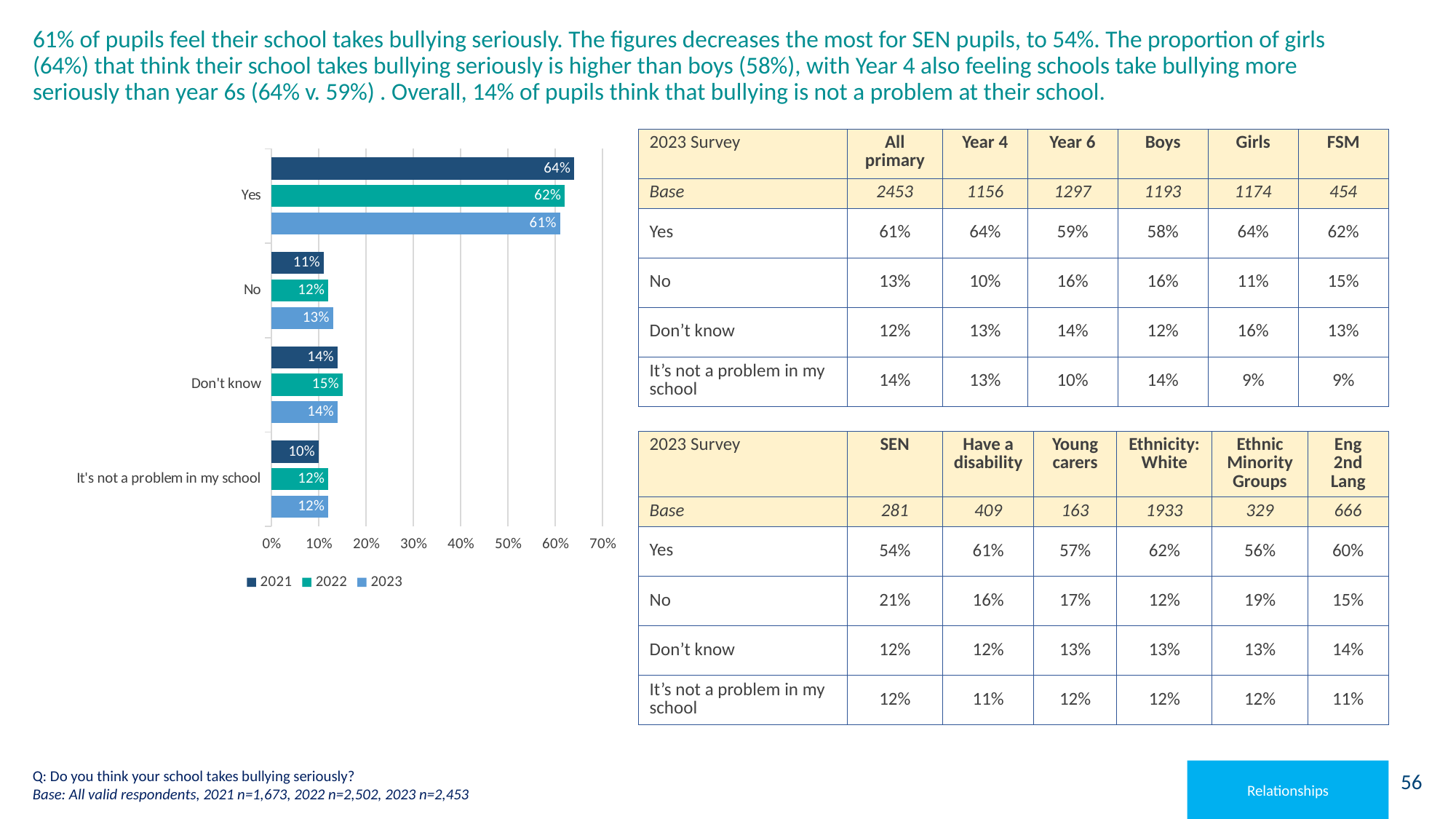
How many series does the chart legend list? 3 What is the 2021 value for 'It's not a problem in my school' in the chart? 10% Does the 'Yes' value rise or fall from 2021 to 2023 in the chart? fall How many response categories are shown on the chart? 4 What is the difference between the 2021 and 2023 values for 'Yes' in the chart? 3% What is the 2023 value for 'Yes' in the chart? 61% What is the 2021 value for 'Yes' in the chart? 64% Which is larger in the chart: the 2021 value for 'No' or the 2023 value for 'No'? 2023 What kind of chart is shown on the slide? bar chart Which response category has the lowest value for 2021 in the chart? It's not a problem in my school What is the 2022 value for 'Don't know' in the chart? 15% Which response category has the highest value for 2023 in the chart? Yes